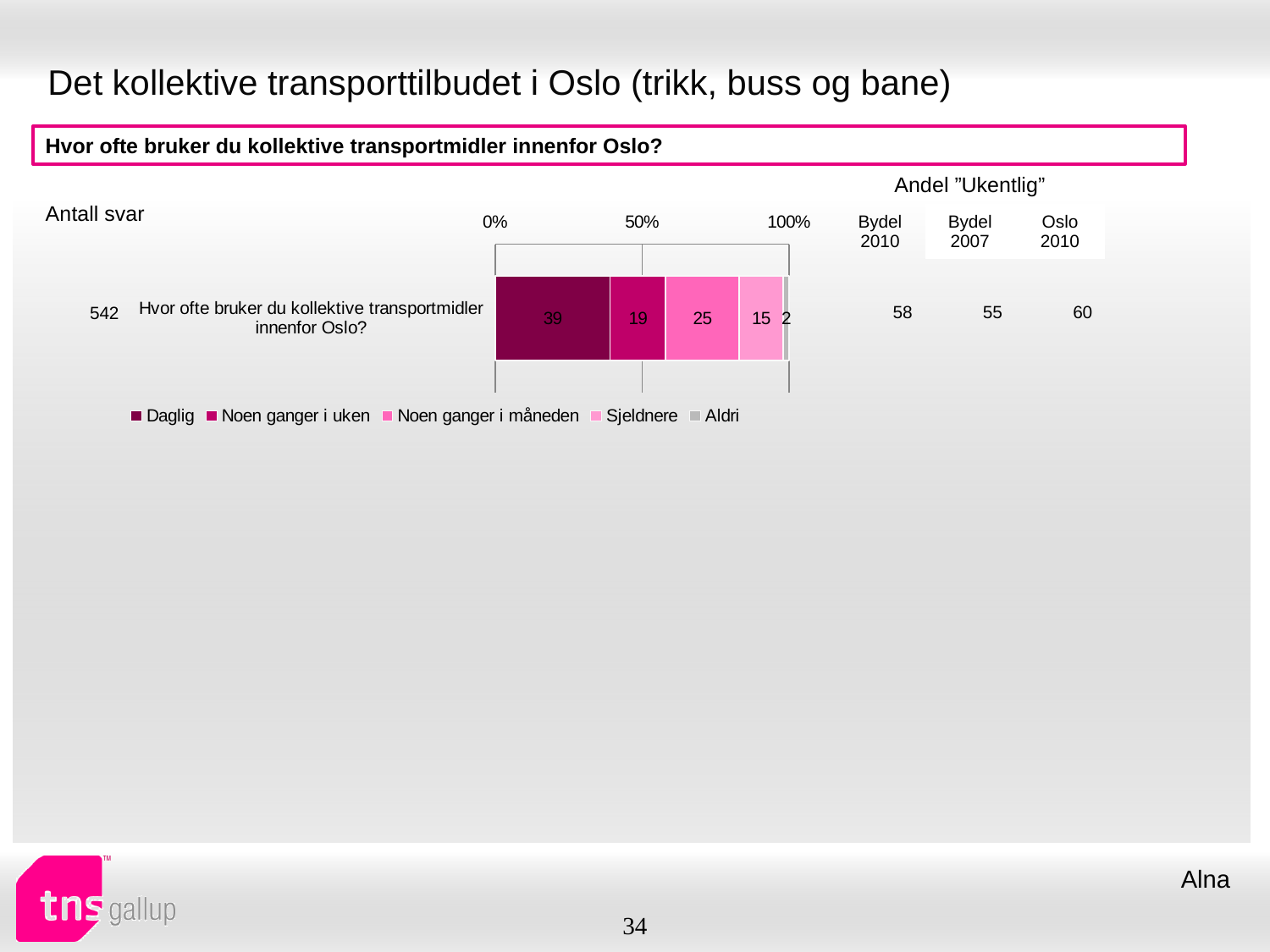
What is the value for "Aldri" in the bar? 2 What is the value for "Daglig" in the bar? 39 What is the difference between the "Daglig" and "Noen ganger i måneden" values? 14 How many series does the chart legend list? 5 What is the value for "Noen ganger i måneden" in the bar? 25 What is the value for "Noen ganger i uken" in the bar? 19 Which legend category has the smallest segment in the bar? Aldri What is the total of all segments in the stacked bar? 100 Which legend category has the largest segment in the bar? Daglig What is the value for "Sjeldnere" in the bar? 15 What kind of chart is shown on the slide? stacked bar chart Which is larger, the "Noen ganger i uken" value or the "Sjeldnere" value? Noen ganger i uken